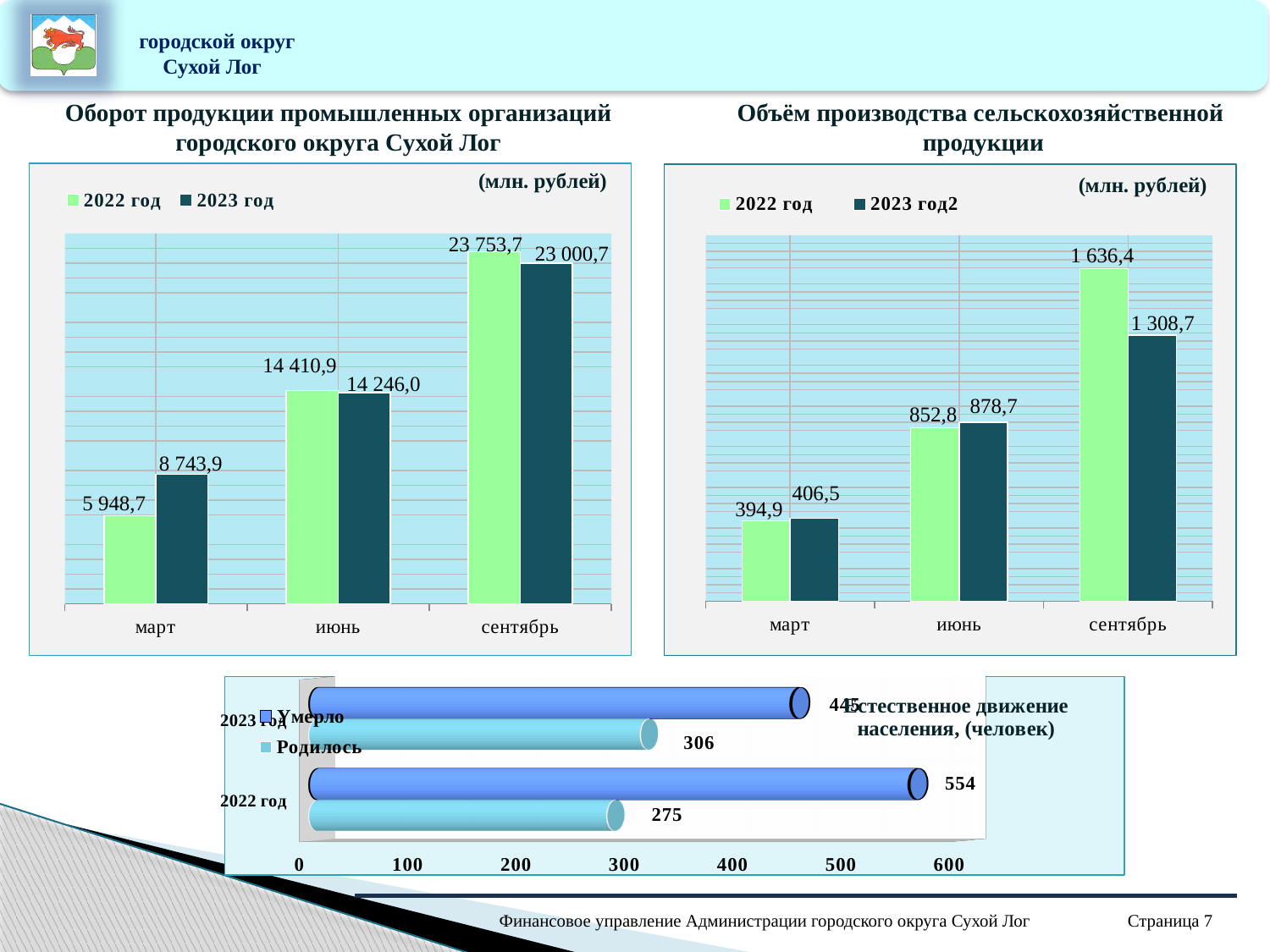
In the chart 'Оборот продукции промышленных организаций городского округа Сухой Лог', which month has the lowest value for 2022 год? март How many series does the legend of the chart 'Объём производства сельскохозяйственной продукции' list? 2 In the chart 'Естественное движение населения, (человек)', what is the value for Умерло in 2022 год? 554 In the chart 'Оборот продукции промышленных организаций городского округа Сухой Лог', what is the difference between the 2022 год and 2023 год values in март? 2 795,2 In the chart 'Оборот продукции промышленных организаций городского округа Сухой Лог', what is the value for 2022 год in сентябрь? 23 753,7 In the chart 'Объём производства сельскохозяйственной продукции', which is larger in сентябрь: 2022 год or 2023 год2? 2022 год What kind of chart is 'Естественное движение населения, (человек)'? bar chart In the chart 'Объём производства сельскохозяйственной продукции', what is the difference between the 2022 год and 2023 год2 values in сентябрь? 327,7 In the chart 'Естественное движение населения, (человек)', what is the value for Родилось in 2023 год? 306 In the chart 'Оборот продукции промышленных организаций городского округа Сухой Лог', what is the value for 2023 год in март? 8 743,9 In the chart 'Оборот продукции промышленных организаций городского округа Сухой Лог', do the values for 2023 год rise or fall from март to сентябрь? rise In the chart 'Объём производства сельскохозяйственной продукции', what is the value for 2022 год in июнь? 852,8